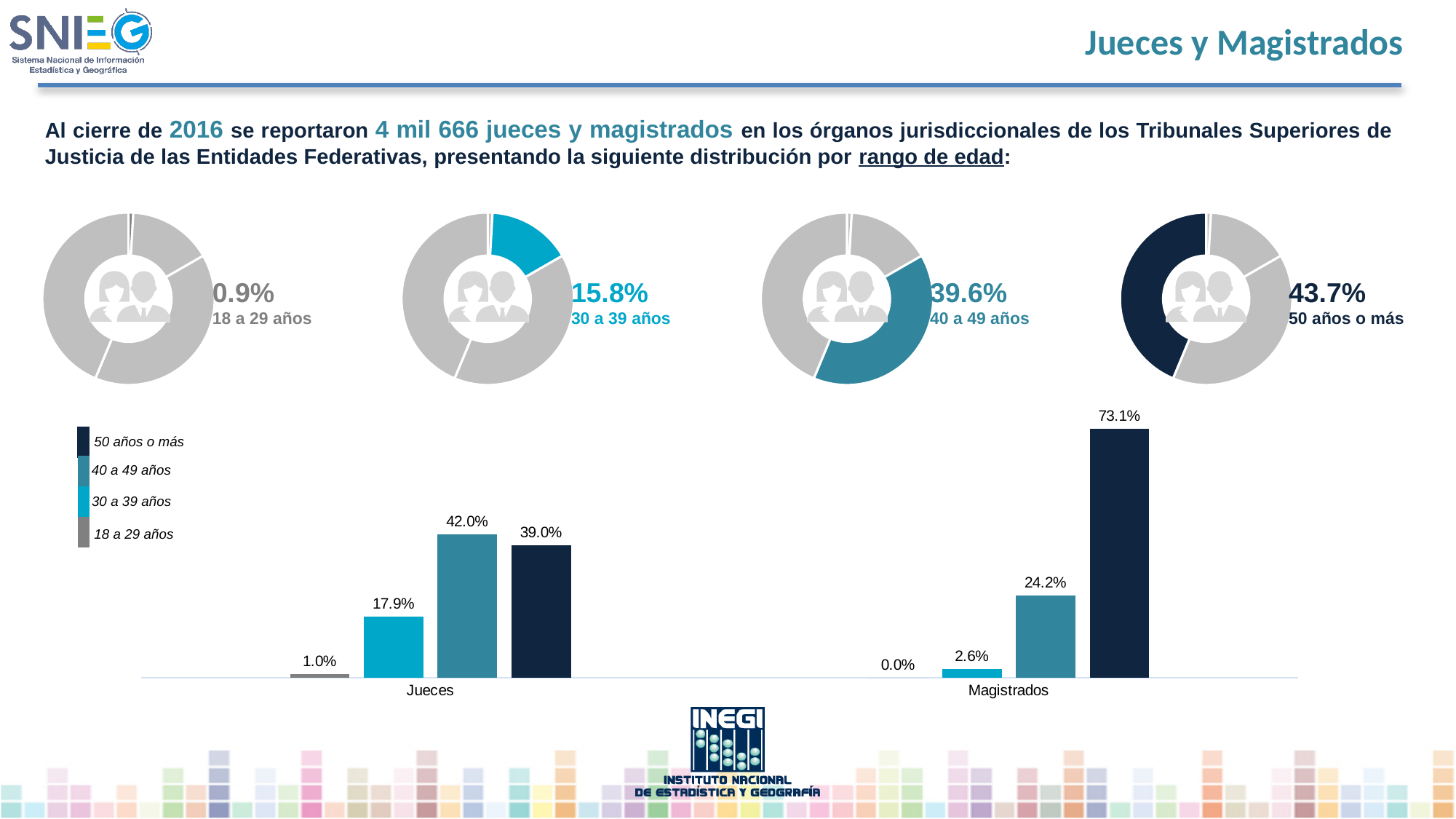
In the bar chart, what is the value for 50 años o más for Magistrados? 73.1% How many categories are shown on the x axis of the bar chart? 2 How many series does the legend of the bar chart list? 4 In the bar chart, which age range has the lowest value for Jueces? 18 a 29 años In the bar chart, which is larger for Jueces: 40 a 49 años or 50 años o más? 40 a 49 años In the donut chart for 40 a 49 años, what share is highlighted? 39.6% What kind of chart is the chart at the bottom of the slide? Bar chart In the bar chart, which age range has the highest value for Magistrados? 50 años o más In the bar chart, what is the value for 40 a 49 años for Jueces? 42.0% In the bar chart, what is the value for 18 a 29 años for Jueces? 1.0% In the bar chart, what is the value for 30 a 39 años for Magistrados? 2.6% In the bar chart, what is the difference between the 50 años o más values for Magistrados and Jueces? 34.1%